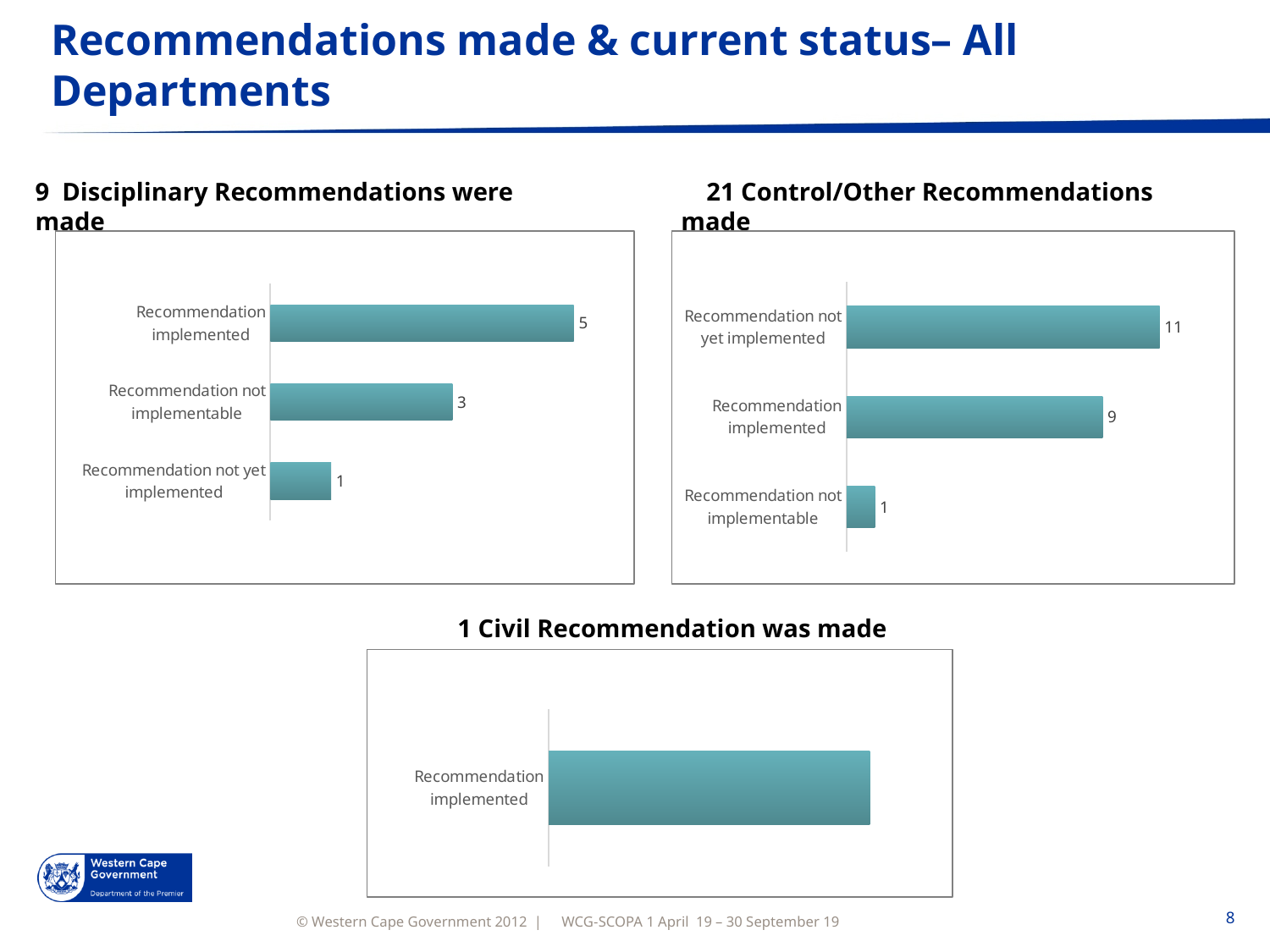
In the '9 Disciplinary Recommendations were made' chart, which is larger: 'Recommendation implemented' or 'Recommendation not yet implemented'? Recommendation implemented In the '9 Disciplinary Recommendations were made' chart, what is the difference between 'Recommendation implemented' and 'Recommendation not implementable'? 2 In the '21 Control/Other Recommendations made' chart, what is the difference between 'Recommendation not yet implemented' and 'Recommendation implemented'? 2 How many categories are shown in the '21 Control/Other Recommendations made' chart? 3 In the '9 Disciplinary Recommendations were made' chart, which category has the lowest value? Recommendation not yet implemented In the '9 Disciplinary Recommendations were made' chart, what is the value for 'Recommendation implemented'? 5 What kind of chart is the '1 Civil Recommendation was made' chart? Bar chart In the '9 Disciplinary Recommendations were made' chart, what is the value for 'Recommendation not implementable'? 3 In the '21 Control/Other Recommendations made' chart, what is the value for 'Recommendation not yet implemented'? 11 How many charts are shown on the slide? 3 In the '21 Control/Other Recommendations made' chart, which category has the highest value? Recommendation not yet implemented In the '21 Control/Other Recommendations made' chart, what is the value for 'Recommendation implemented'? 9